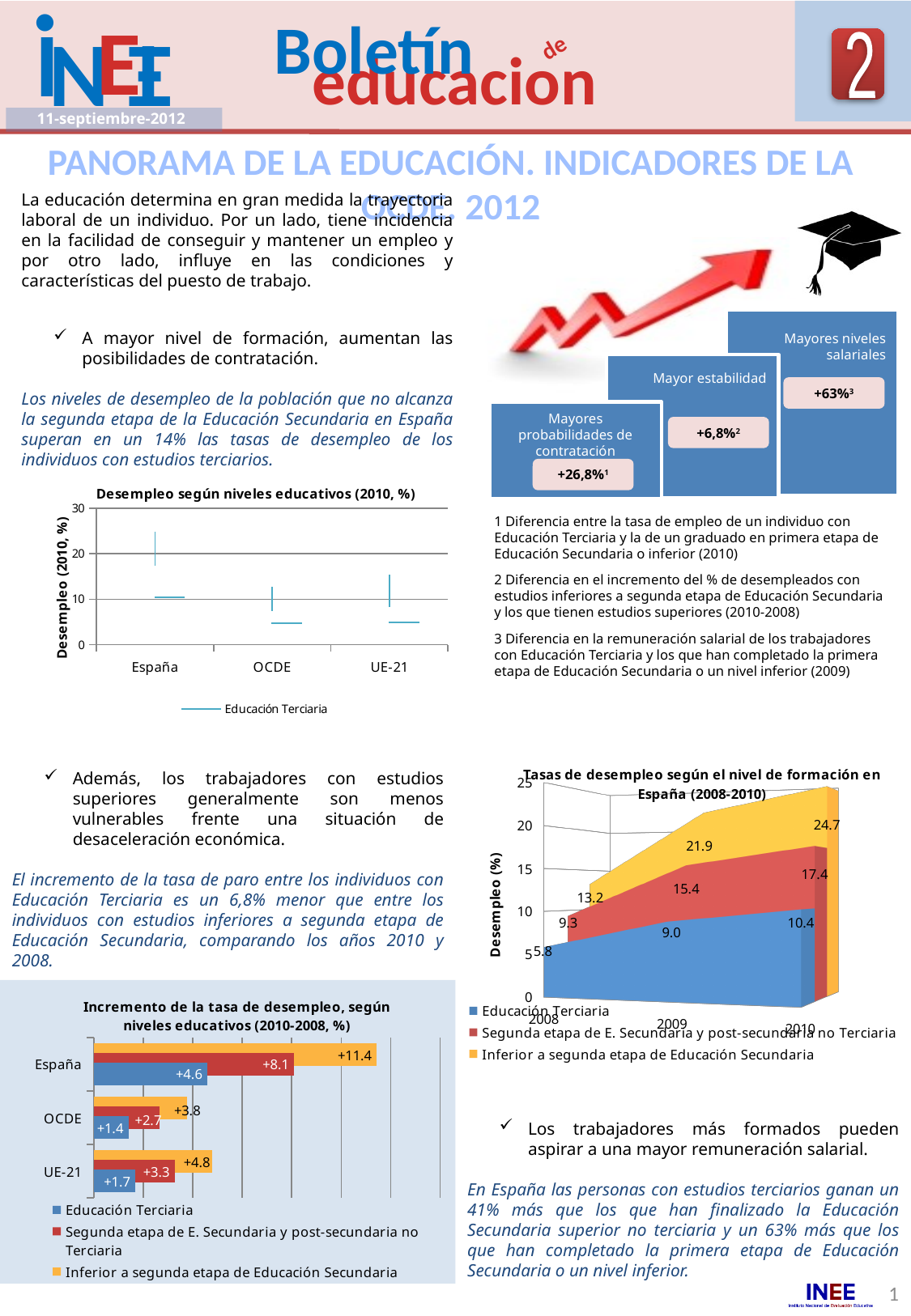
In the chart 'Tasas de desempleo según el nivel de formación en España (2008-2010)', what is the value for Inferior a segunda etapa de Educación Secundaria in 2010? 24.7 In the chart 'Tasas de desempleo según el nivel de formación en España (2008-2010)', what is the value for Educación Terciaria in 2008? 5.8 In the chart 'Incremento de la tasa de desempleo, según niveles educativos (2010-2008, %)', what is the value for Educación Terciaria in OCDE? +1.4 What kind of chart is 'Incremento de la tasa de desempleo, según niveles educativos (2010-2008, %)'? Bar chart In the chart 'Incremento de la tasa de desempleo, según niveles educativos (2010-2008, %)', what is the difference between the Inferior a segunda etapa de Educación Secundaria value and the Educación Terciaria value for UE-21? 3.1 How many series does the legend of the chart 'Incremento de la tasa de desempleo, según niveles educativos (2010-2008, %)' list? 3 In the chart 'Incremento de la tasa de desempleo, según niveles educativos (2010-2008, %)', what is the value for Inferior a segunda etapa de Educación Secundaria in España? +11.4 In the chart 'Incremento de la tasa de desempleo, según niveles educativos (2010-2008, %)', which category has the highest value for Segunda etapa de E. Secundaria y post-secundaria no Terciaria? España In the chart 'Tasas de desempleo según el nivel de formación en España (2008-2010)', what is the difference between the Inferior a segunda etapa de Educación Secundaria value and the Educación Terciaria value in 2009? 12.9 How many categories are shown on the x axis of the chart 'Desempleo según niveles educativos (2010, %)'? 3 In the chart 'Tasas de desempleo según el nivel de formación en España (2008-2010)', does the Segunda etapa de E. Secundaria y post-secundaria no Terciaria series rise or fall from 2008 to 2010? Rise In the chart 'Desempleo según niveles educativos (2010, %)', is the Educación Terciaria value for OCDE greater or less than 10? less